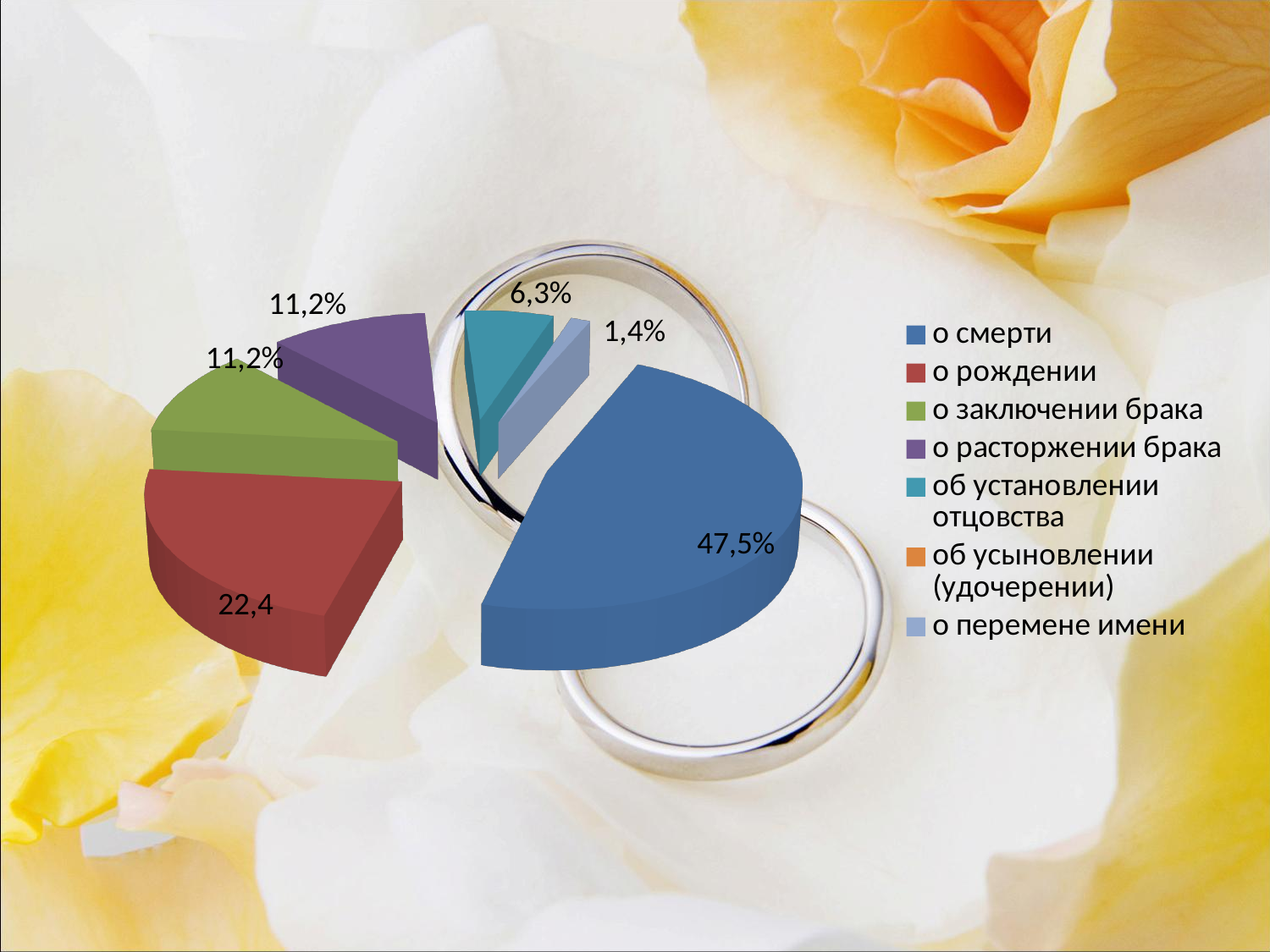
What percentage is shown for the slice 'об установлении отцовства'? 6,3% What percentage is shown for the slice 'о перемене имени'? 1,4% What value is shown for the slice 'о рождении'? 22,4 What is the difference in percentage points between the 'о смерти' slice and the 'об установлении отцовства' slice? 41,2 What percentage is shown for the slice 'о заключении брака'? 11,2% Which slice is larger, 'о расторжении брака' or 'об установлении отцовства'? о расторжении брака How many entries does the legend list? 7 Which slice is larger, 'о смерти' or 'о рождении'? о смерти What kind of chart is shown on the slide? pie chart What percentage is shown for the slice 'о смерти'? 47,5% What colour is the slice for 'о расторжении брака'? purple Which category has the largest slice of the pie? о смерти